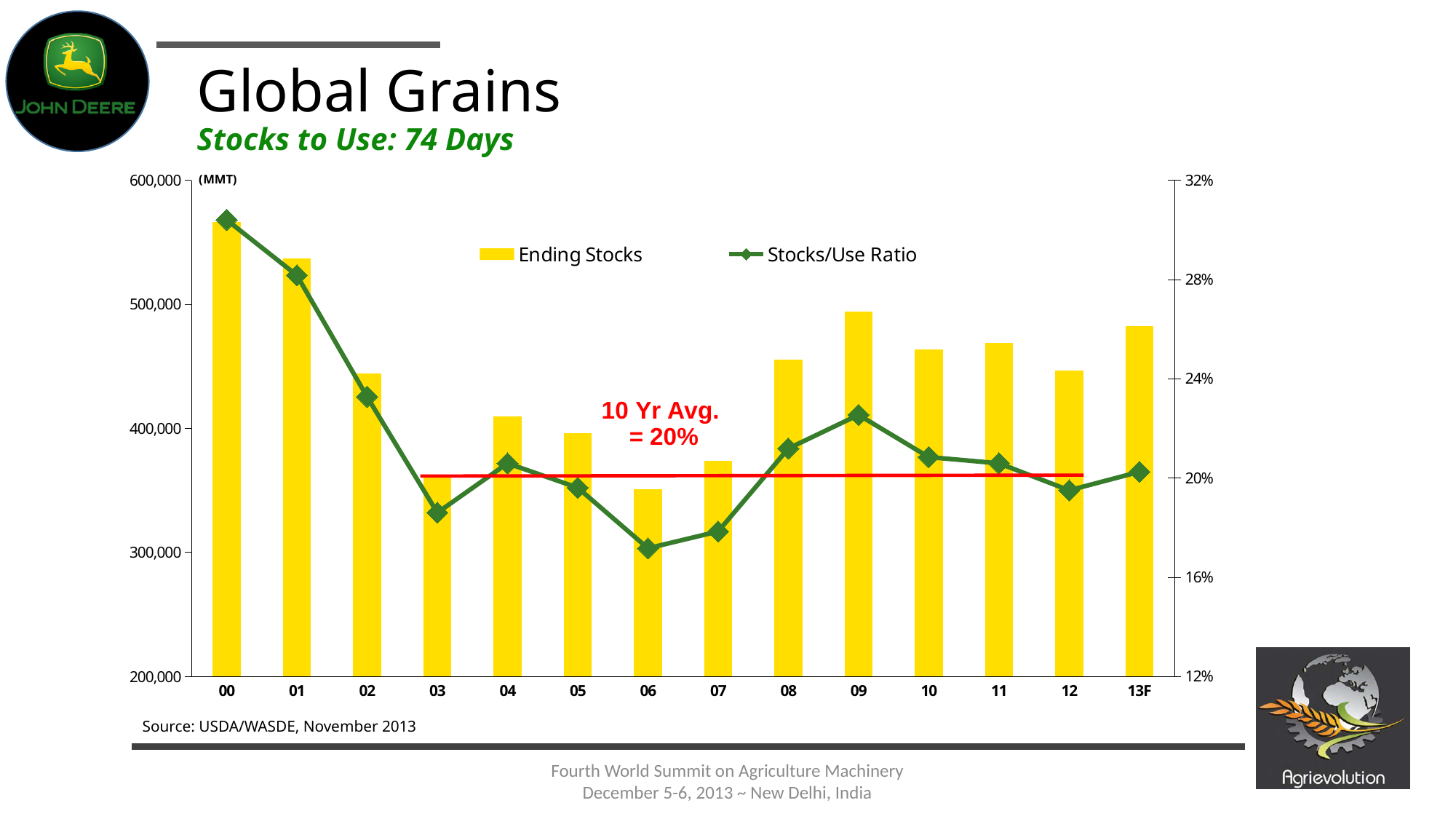
In which year is the Stocks/Use Ratio highest? 00 In which year are Ending Stocks highest? 00 Do Ending Stocks rise or fall from 00 to 03? fall In which year is the Stocks/Use Ratio lowest? 06 Is the Ending Stocks value for 00 greater or less than 500,000? greater How many series does the chart legend list? 2 What kind of chart is shown on the slide? A combined bar and line chart How many years (categories) are shown on the x axis? 14 Which year has higher Ending Stocks, 08 or 09? 09 Is the Stocks/Use Ratio for 06 greater or less than 20%? less Is the Ending Stocks value for 06 greater or less than 400,000? less What value does the red horizontal line labelled '10 Yr Avg.' represent? 20%